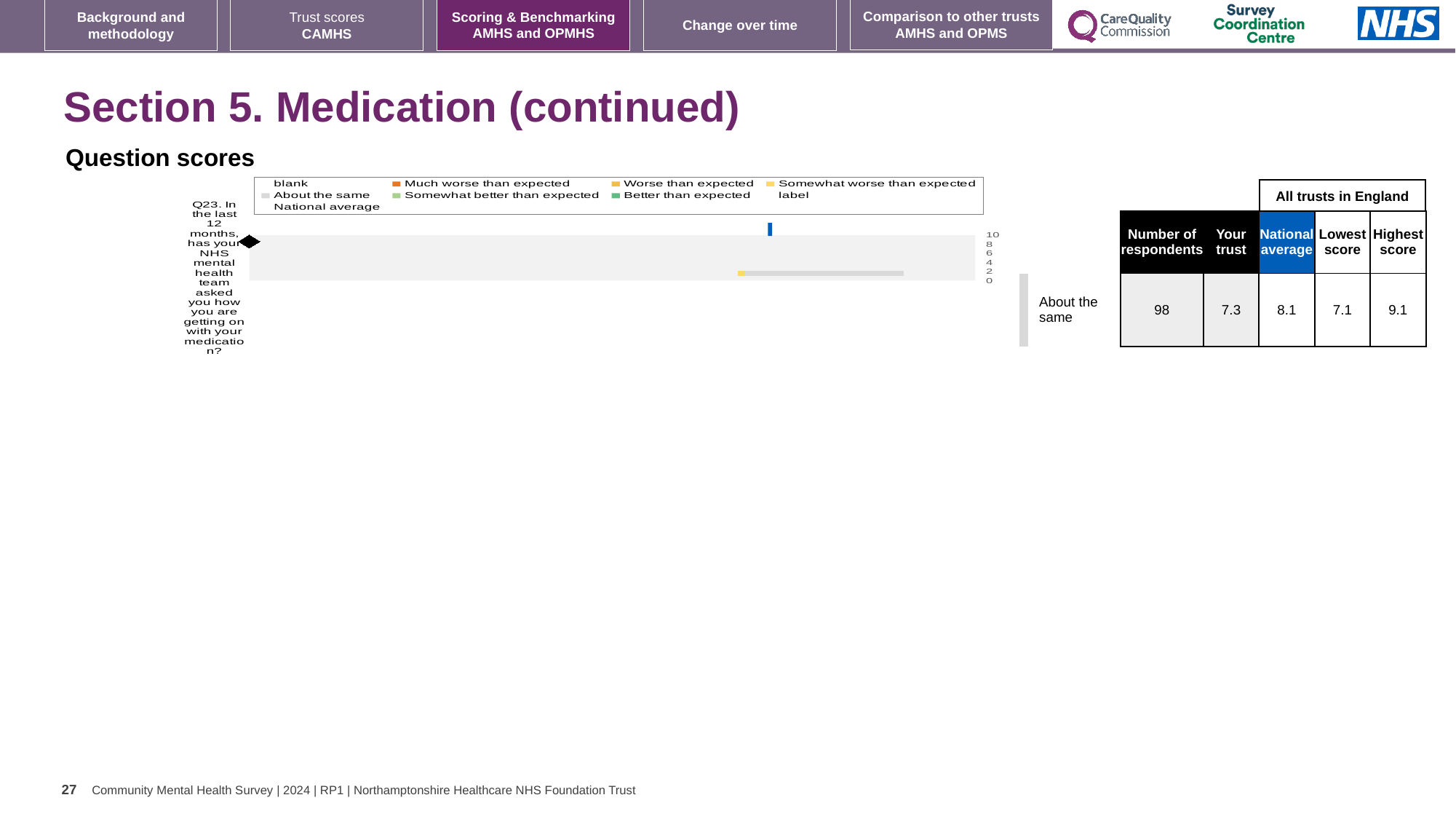
In the table beside the chart, what is the Lowest score for Q23? 7.1 In the table beside the chart, how many respondents answered Q23? 98 In the table beside the chart, what is the Highest score for Q23? 9.1 What kind of chart is shown under 'Question scores'? bar chart In the table beside the chart, what is the 'Your trust' score for Q23? 7.3 In the table beside the chart, what is the National average for Q23? 8.1 What benchmark category label is shown to the right of the chart for Q23? About the same What is the highest tick value shown on the chart's numeric axis? 10 Which is larger for Q23, the 'Your trust' score or the National average? National average How many entries does the chart's legend list? 9 Which legend entry is shown with an orange marker? Much worse than expected How many question categories are plotted in the chart? 1